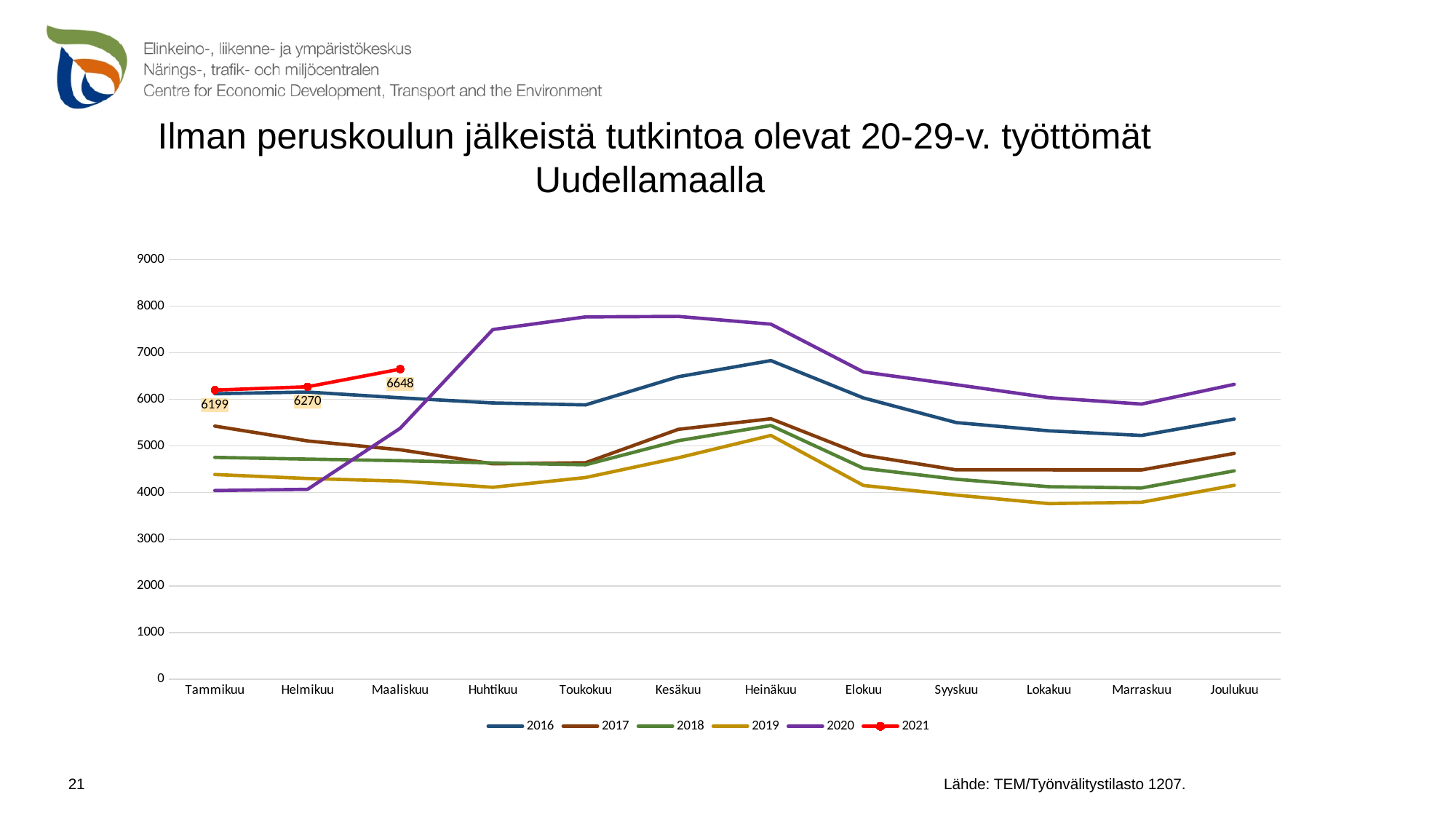
Which series has the lowest value in Lokakuu? 2019 What is the value for 2021 in Tammikuu? 6199 What is the value for 2021 in Maaliskuu? 6648 How many months are shown on the x axis? 12 What is the difference between the 2021 values for Maaliskuu and Helmikuu? 378 Which series has the highest value in Toukokuu? 2020 What is the value for 2021 in Helmikuu? 6270 What is the difference between the 2021 values for Maaliskuu and Tammikuu? 449 What kind of chart is shown on the slide? Line chart Is the value for 2020 in Toukokuu greater or less than 7000? greater Does the 2021 line rise or fall from Tammikuu to Maaliskuu? Rises How many series does the legend list? 6